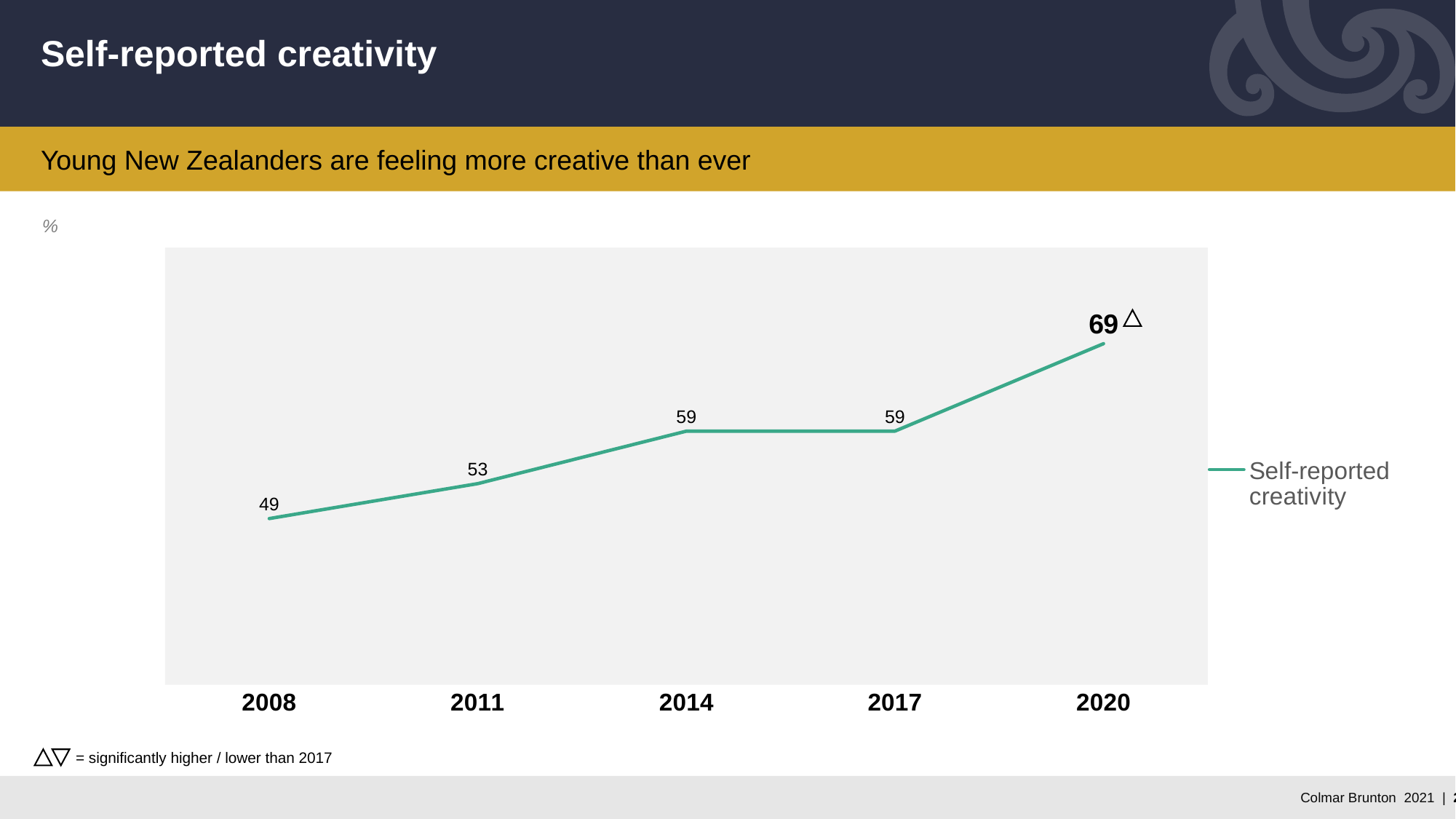
How many years are plotted on the chart? 5 What is the difference between the 2011 and 2008 self-reported creativity values? 4 Do the self-reported creativity values generally rise or fall from 2008 to 2020? Rise Which year has the lowest self-reported creativity value? 2008 How many series does the legend list? 1 What is the self-reported creativity value for 2008? 49 What is the self-reported creativity value for 2020? 69 Which year has the highest self-reported creativity value? 2020 What is the difference between the 2020 and 2017 self-reported creativity values? 10 What is the self-reported creativity value for 2011? 53 What kind of chart is shown on the slide? Line chart Which year has a larger self-reported creativity value, 2011 or 2014? 2014